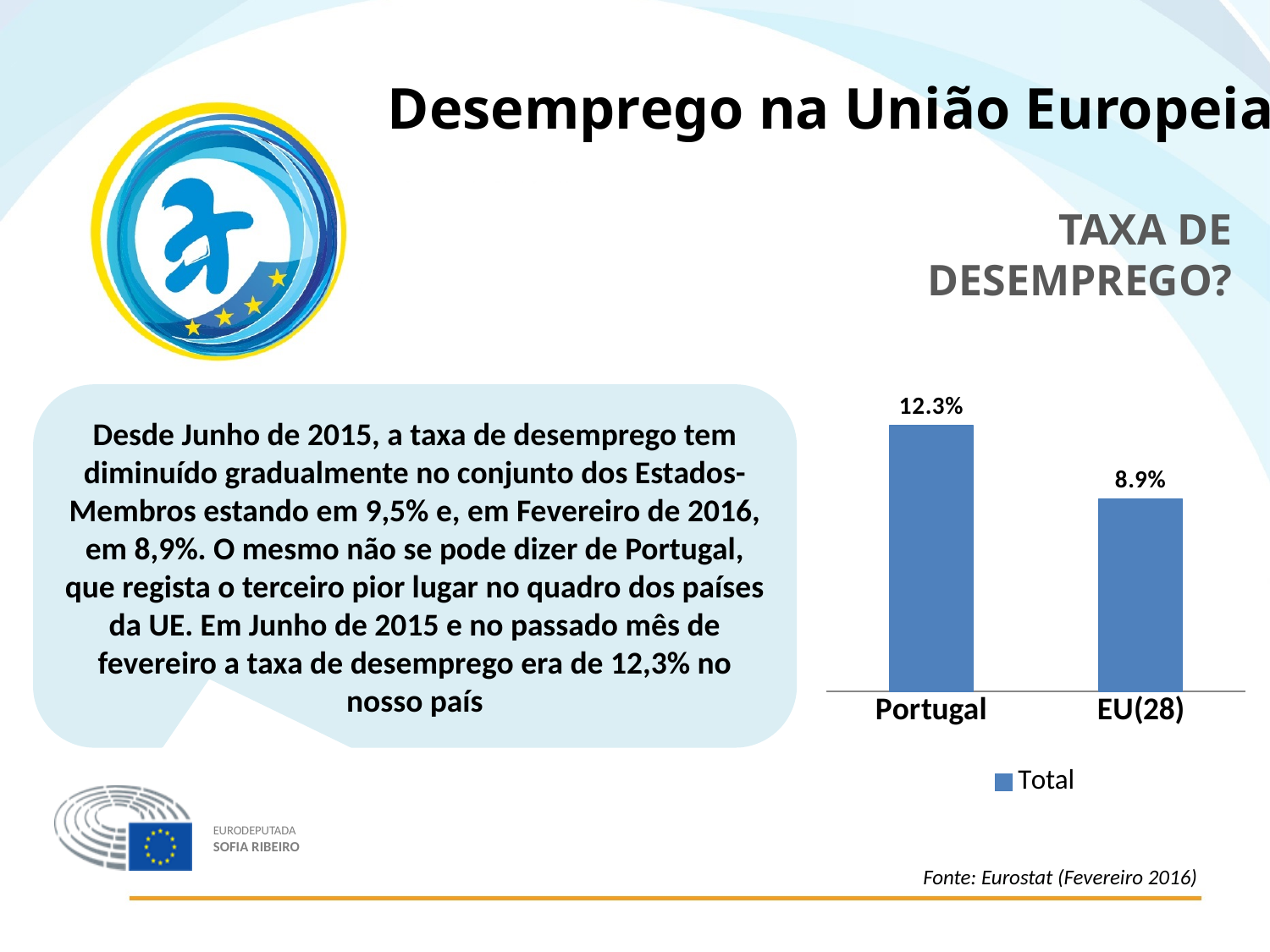
What is the difference between the values for Portugal and EU(28)? 3.4% What is the value for EU(28) in the chart? 8.9% Which category has the highest value in the chart? Portugal Which category has the lowest value in the chart? EU(28) How many categories are shown in the chart? 2 What is the value for Portugal in the chart? 12.3% What kind of chart is shown on the slide? Bar chart What colour are the bars in the chart? Blue How many series does the chart legend list? 1 Which is larger, the value for Portugal or the value for EU(28)? Portugal What is the name of the series shown in the chart legend? Total